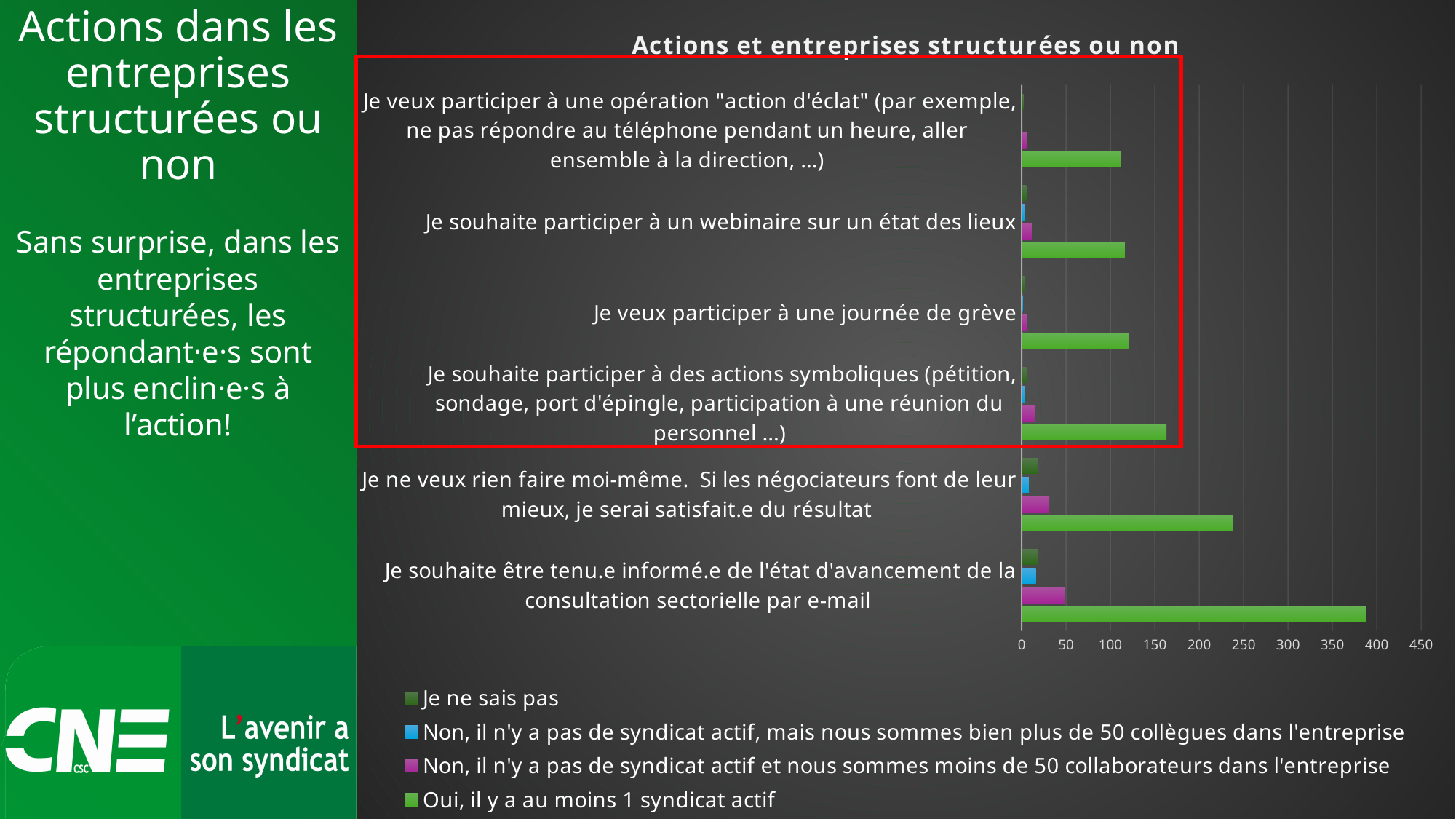
Is the value of "Oui, il y a au moins 1 syndicat actif" for "Je ne veux rien faire moi-même. Si les négociateurs font de leur mieux, je serai satisfait.e du résultat" greater or less than 200? greater Is the value of "Oui, il y a au moins 1 syndicat actif" for "Je veux participer à une opération 'action d'éclat'" greater or less than 150? less What kind of chart is shown on the slide? bar chart Which category has the highest value for the series "Oui, il y a au moins 1 syndicat actif"? Je souhaite être tenu.e informé.e de l'état d'avancement de la consultation sectorielle par e-mail How many series does the chart's legend list? 4 Is the value of "Oui, il y a au moins 1 syndicat actif" for "Je souhaite être tenu.e informé.e de l'état d'avancement de la consultation sectorielle par e-mail" greater or less than 350? greater What is the title of the chart? Actions et entreprises structurées ou non How many categories (statements) are plotted on the chart? 6 For the series "Oui, il y a au moins 1 syndicat actif", which is larger: "Je ne veux rien faire moi-même" or "Je veux participer à une journée de grève"? Je ne veux rien faire moi-même Which colour represents the series "Oui, il y a au moins 1 syndicat actif" in the legend? green